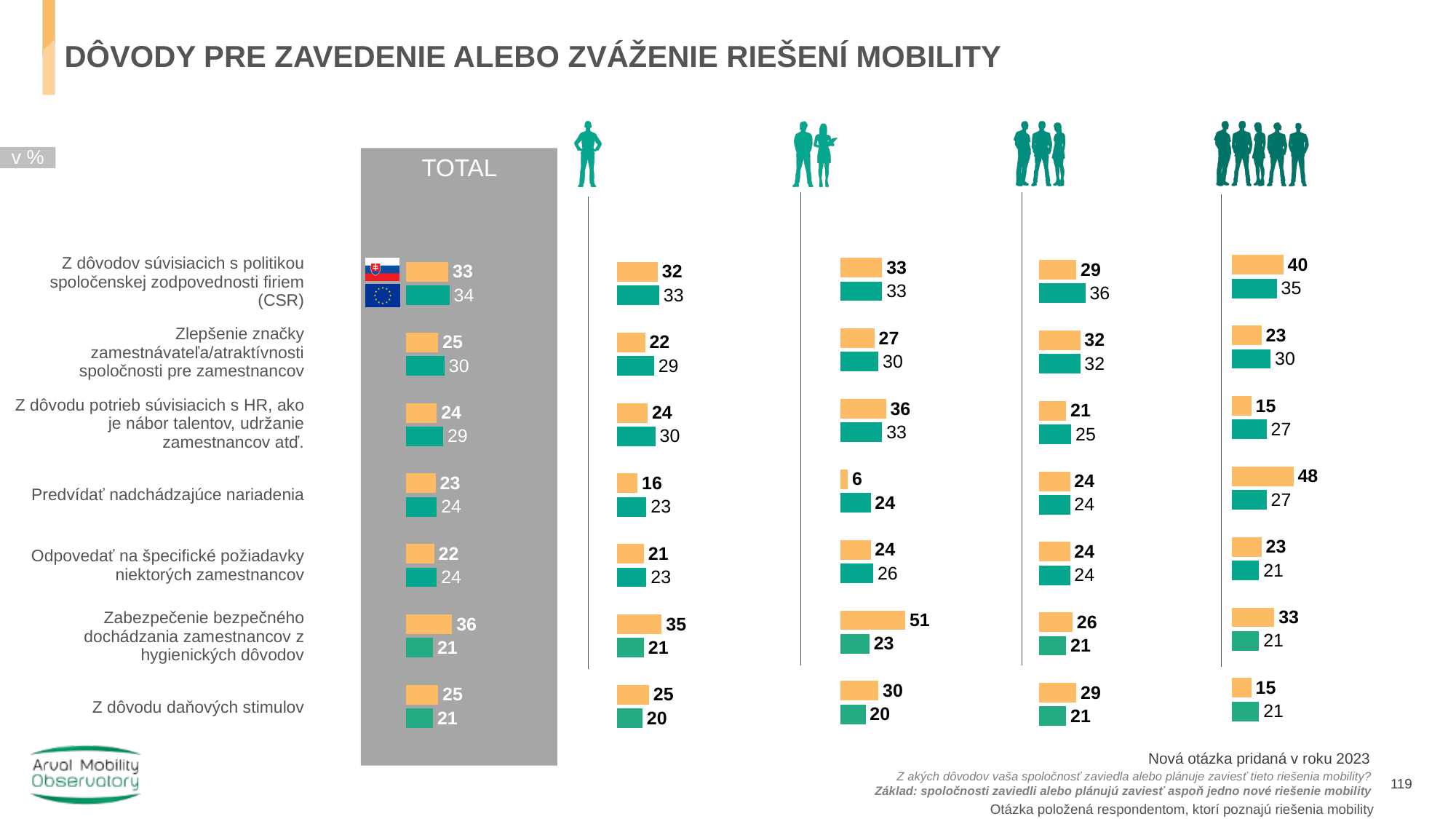
In the TOTAL chart, which category has the lowest orange (Slovak flag) value? Odpovedať na špecifické požiadavky niektorých zamestnancov In the rightmost chart (largest group icon), what is the orange (Slovak flag) value for "Predvídať nadchádzajúce nariadenia"? 48 In the TOTAL chart, what is the green (EU flag) value for "Z dôvodov súvisiacich s politikou spoločenskej zodpovednosti firiem (CSR)"? 34 In the TOTAL chart, what is the difference between the orange and green values for "Zabezpečenie bezpečného dochádzania zamestnancov z hygienických dôvodov"? 15 In the second chart to the right of TOTAL (two-person icon), what is the orange (Slovak flag) value for "Zabezpečenie bezpečného dochádzania zamestnancov z hygienických dôvodov"? 51 In the TOTAL chart, which category has the highest orange (Slovak flag) value? Zabezpečenie bezpečného dochádzania zamestnancov z hygienických dôvodov How many categories (reasons) are listed in the TOTAL chart? 7 In the second chart to the right of TOTAL (two-person icon), which category has the lowest orange (Slovak flag) value? Predvídať nadchádzajúce nariadenia In the TOTAL chart, what is the orange (Slovak flag) value for "Z dôvodu daňových stimulov"? 25 How many series (flags) does the TOTAL chart show? 2 In the first chart to the right of TOTAL (single-person icon), for "Zlepšenie značky zamestnávateľa/atraktívnosti spoločnosti pre zamestnancov", is the orange or the green value larger? green What kind of chart is the TOTAL chart? bar chart